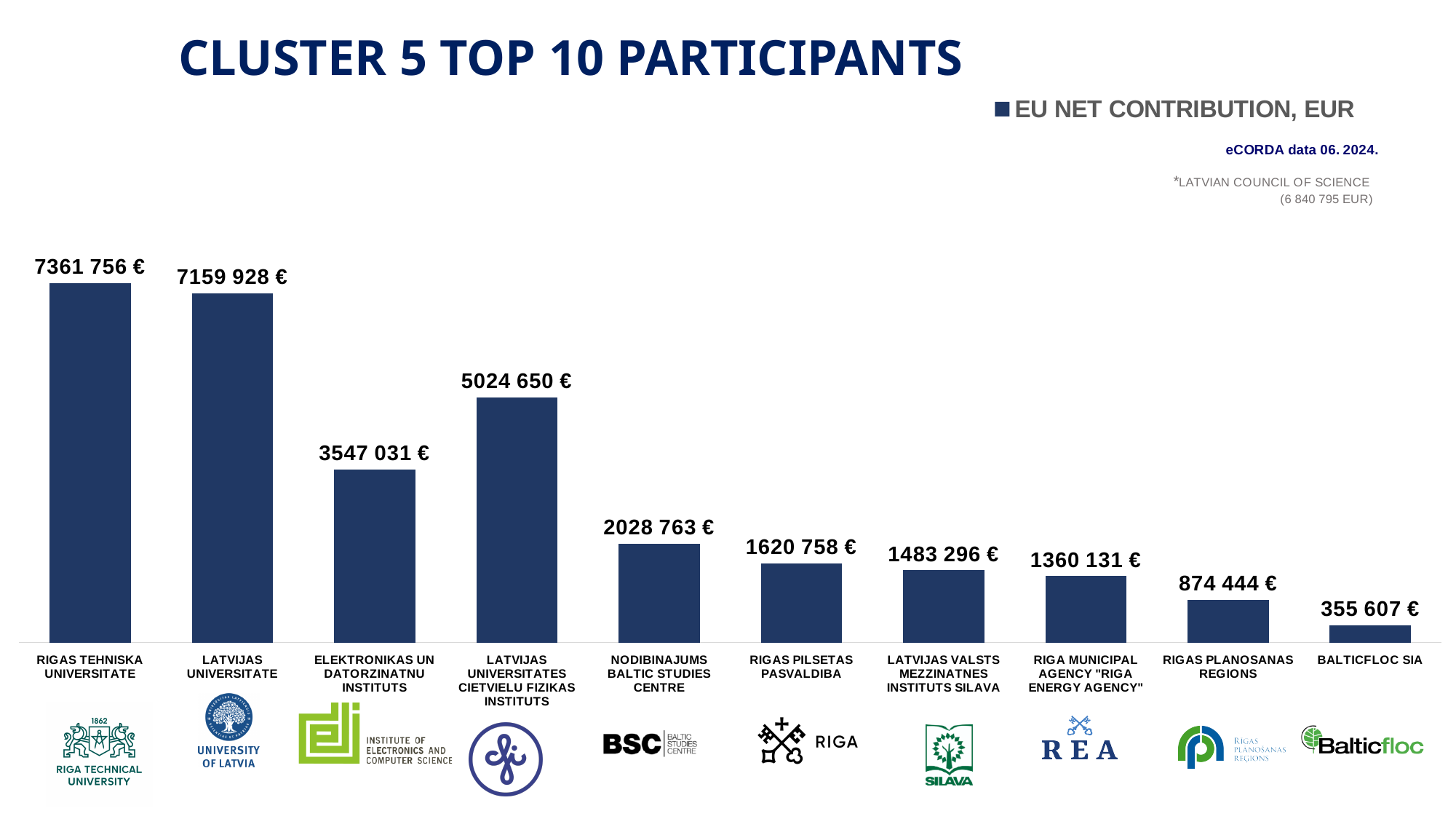
Which participant has the highest EU net contribution? RIGAS TEHNISKA UNIVERSITATE What is the EU net contribution for RIGAS TEHNISKA UNIVERSITATE? 7361 756 € What kind of chart is shown on the slide? bar chart What is the EU net contribution for NODIBINAJUMS BALTIC STUDIES CENTRE? 2028 763 € Which participant has the lowest EU net contribution? BALTICFLOC SIA What is the difference between the EU net contributions of RIGAS TEHNISKA UNIVERSITATE and LATVIJAS UNIVERSITATE? 201 828 € How many series does the legend list? 1 What is the legend entry of the chart? EU NET CONTRIBUTION, EUR How many participants are shown in the chart? 10 What is the EU net contribution for RIGA MUNICIPAL AGENCY "RIGA ENERGY AGENCY"? 1360 131 € What is the EU net contribution for BALTICFLOC SIA? 355 607 € Which has a larger EU net contribution, ELEKTRONIKAS UN DATORZINATNU INSTITUTS or LATVIJAS UNIVERSITATES CIETVIELU FIZIKAS INSTITUTS? LATVIJAS UNIVERSITATES CIETVIELU FIZIKAS INSTITUTS